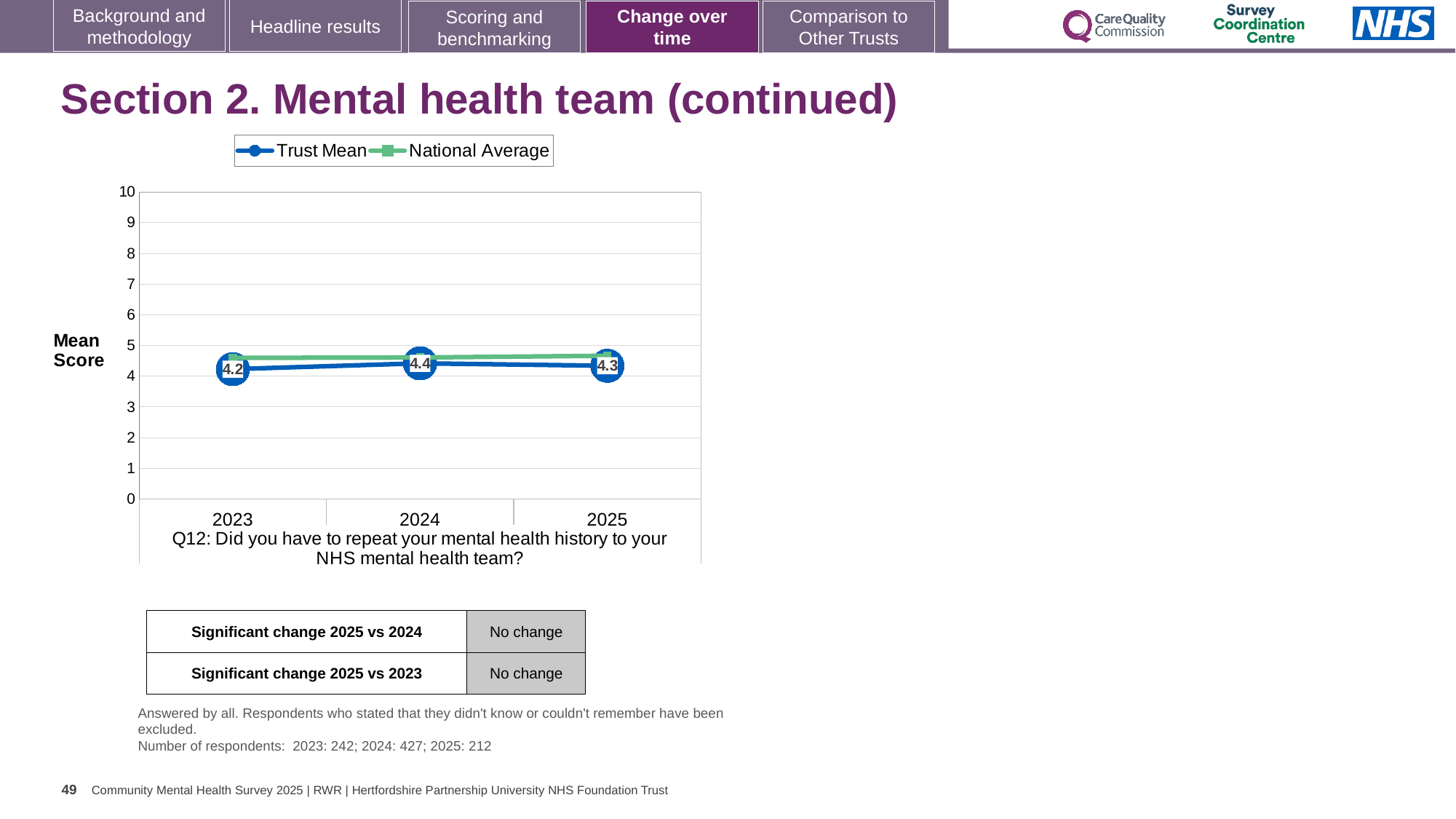
Does the Trust Mean rise or fall from 2023 to 2024? rise What is the difference between the Trust Mean scores for 2024 and 2023? 0.2 In which year is the Trust Mean score highest? 2024 In which year is the Trust Mean score lowest? 2023 What is the Trust Mean score for 2024? 4.4 How many series does the legend list? 2 What kind of chart is shown on the slide? line chart What is the Trust Mean score for 2023? 4.2 Is the National Average value for 2025 greater or less than 5? less What is the Trust Mean score for 2025? 4.3 How many years are plotted on the x axis? 3 Which is larger, the Trust Mean score for 2024 or for 2025? 2024